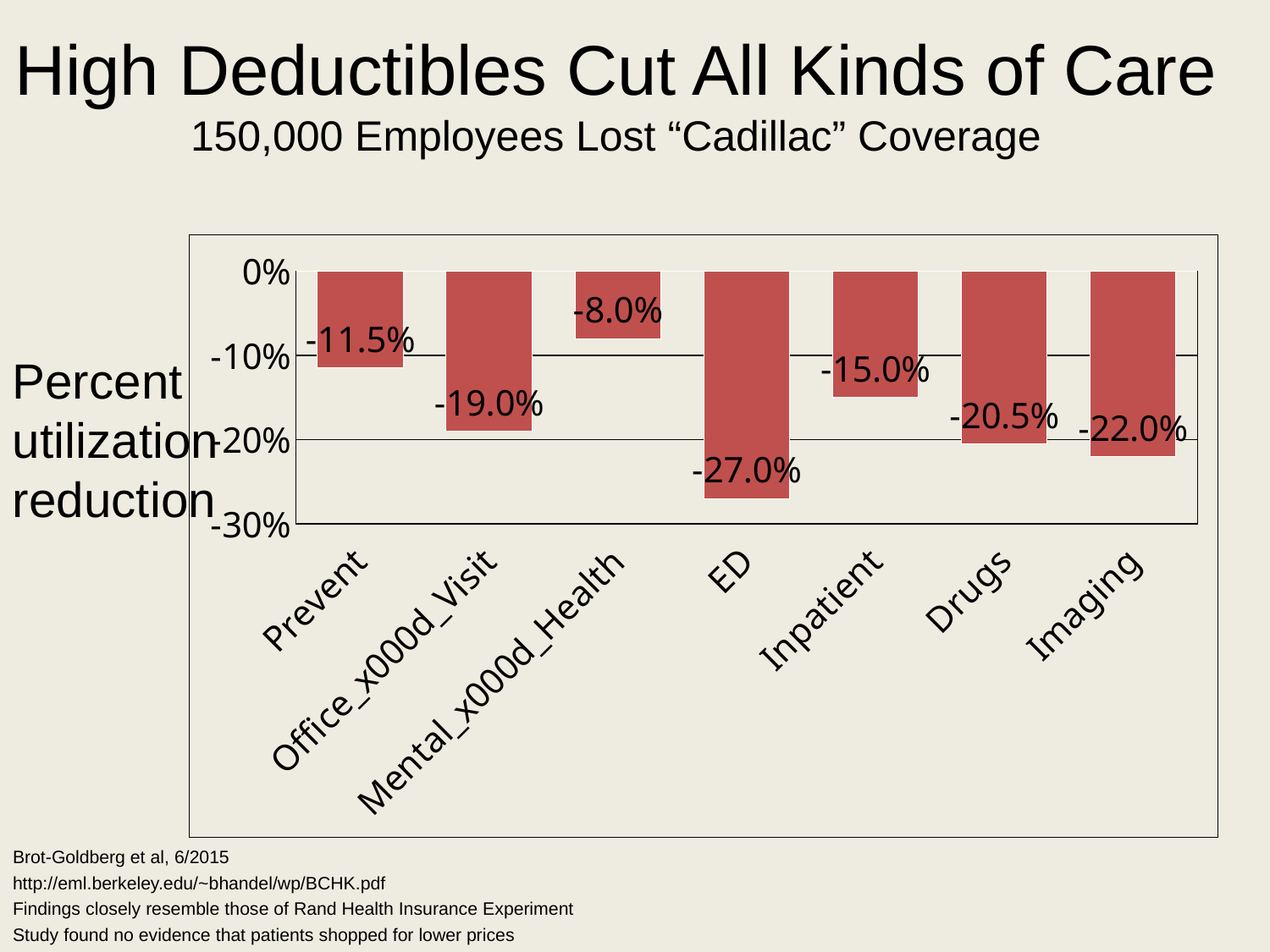
Which has the larger utilization reduction, Drugs or Inpatient? Drugs What is the label on the vertical axis of the chart? Percent utilization reduction What is the value for Imaging? -22.0% Which category shows the largest utilization reduction? ED What is the difference in percentage points between the values for Imaging and Drugs? 1.5 percentage points What kind of chart is shown on the slide? Bar chart How many categories are shown in the chart? 7 What is the value for Prevent? -11.5% Is the value for Imaging greater or less than -20%? less What is the value for ED? -27.0% What is the value for Office_x000d_Visit? -19.0% Which category shows the smallest utilization reduction? Mental_x000d_Health